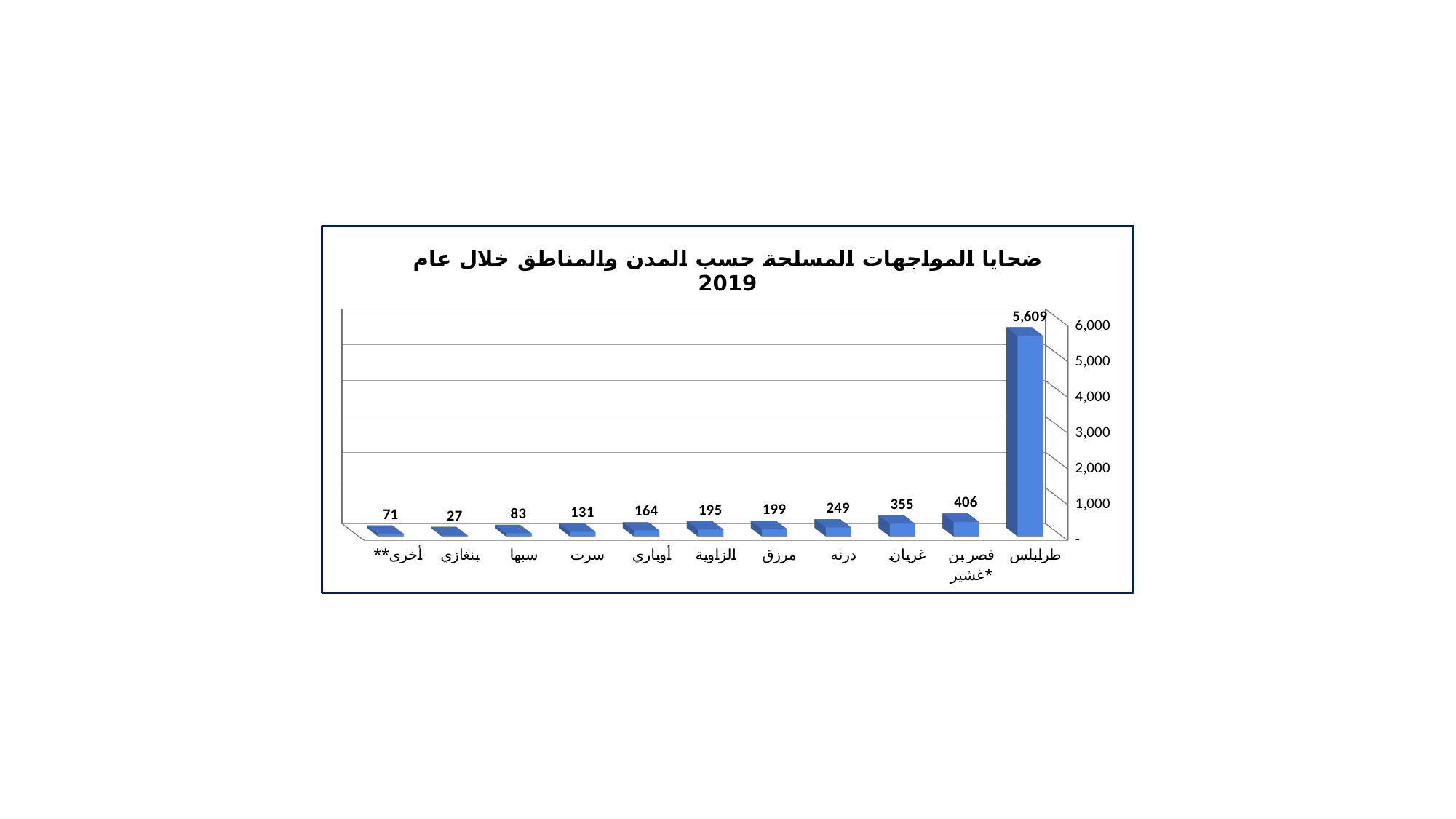
What is the value for بنغازي? 27 Which is larger, the value for درنه or the value for مرزق? درنه What is the difference between the values for سرت and سبها? 48 How many categories are shown on the x axis? 11 Is the value for طرابلس greater or less than 5,000? greater What is the value for طرابلس? 5,609 What is the value for أخرى**? 71 What is the difference between the values for قصر بن غشير* and غريان? 51 What kind of chart is shown? bar chart Which category has the lowest value? بنغازي What is the value for غريان? 355 Which category has the highest value? طرابلس